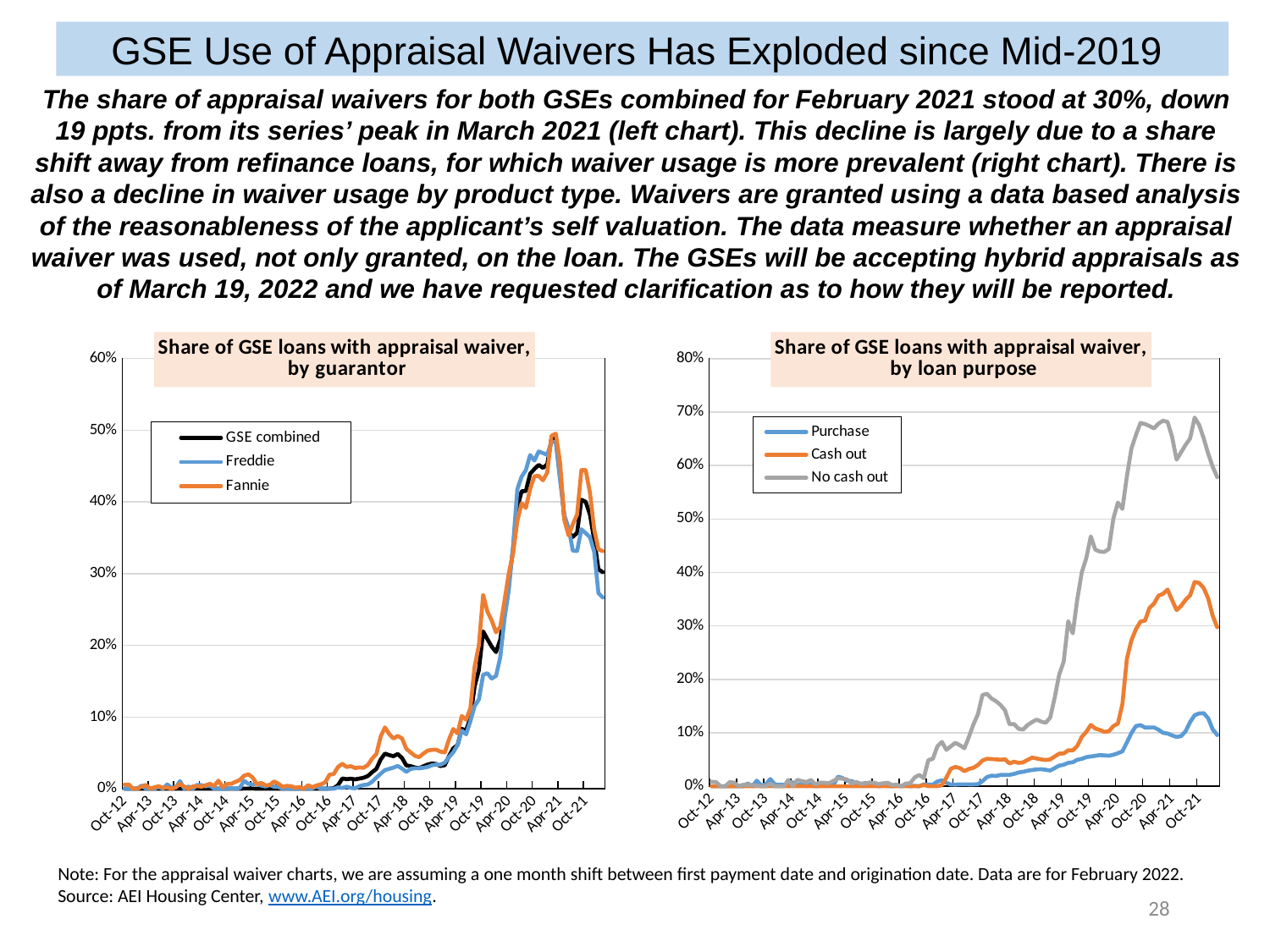
In the right chart, 'Share of GSE loans with appraisal waiver, by loan purpose', which is larger at Oct-21: No cash out or Cash out? No cash out What kind of chart is the left chart, 'Share of GSE loans with appraisal waiver, by guarantor'? Line chart In the left chart, 'Share of GSE loans with appraisal waiver, by guarantor', is the GSE combined series at Apr-16 greater or less than 10%? less In the right chart, 'Share of GSE loans with appraisal waiver, by loan purpose', is the Purchase series at Oct-21 greater or less than 20%? less In the left chart, 'Share of GSE loans with appraisal waiver, by guarantor', do the values of the GSE combined series rise or fall between Apr-18 and Apr-21? rise What are the three legend entries of the left chart, 'Share of GSE loans with appraisal waiver, by guarantor'? GSE combined, Freddie, Fannie How many series does the legend of the left chart, 'Share of GSE loans with appraisal waiver, by guarantor', list? 3 In the right chart, 'Share of GSE loans with appraisal waiver, by loan purpose', which series is highest at the end of the period (Oct-21)? No cash out In the left chart, 'Share of GSE loans with appraisal waiver, by guarantor', is the peak value of the Fannie series greater or less than 40%? greater In the right chart, 'Share of GSE loans with appraisal waiver, by loan purpose', which series is lowest at the end of the period (Oct-21)? Purchase How many series does the legend of the right chart, 'Share of GSE loans with appraisal waiver, by loan purpose', list? 3